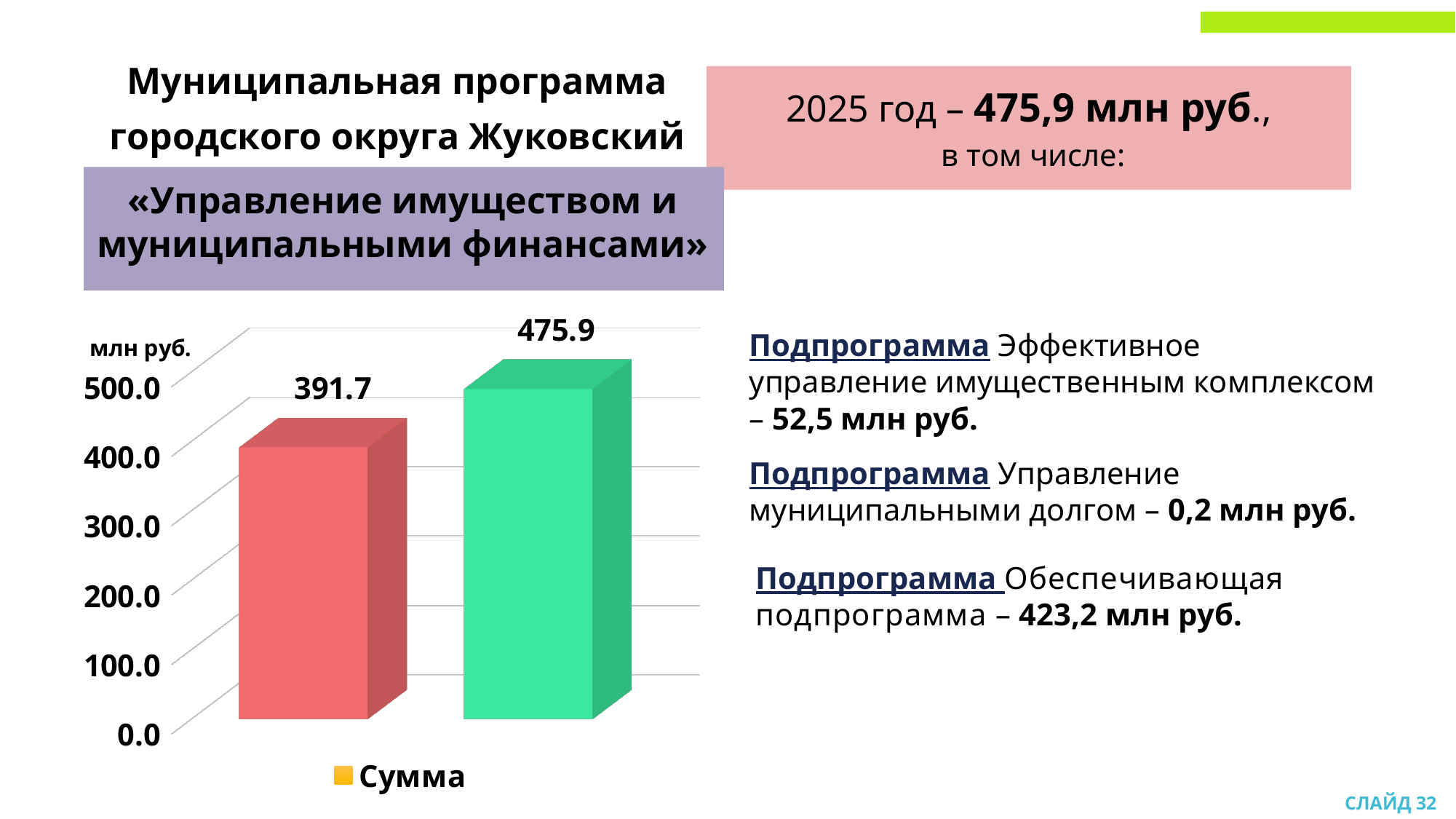
What is the difference between the two bar values on the chart? 84.2 Is the value of the left (red) bar greater or less than 400.0? less What type of chart is shown on the slide? bar chart How many bars are plotted on the chart? 2 Which bar has the higher value, the left (red) bar or the right (green) bar? the right (green) bar What series name is shown in the chart legend? Сумма What is the value shown on the right (green) bar of the chart? 475.9 Do the values rise or fall from the left bar to the right bar? rise Is the value of the right (green) bar greater or less than 400.0? greater What is the lowest value plotted on the chart? 391.7 What is the highest value plotted on the chart? 475.9 What is the value shown on the left (red) bar of the chart? 391.7